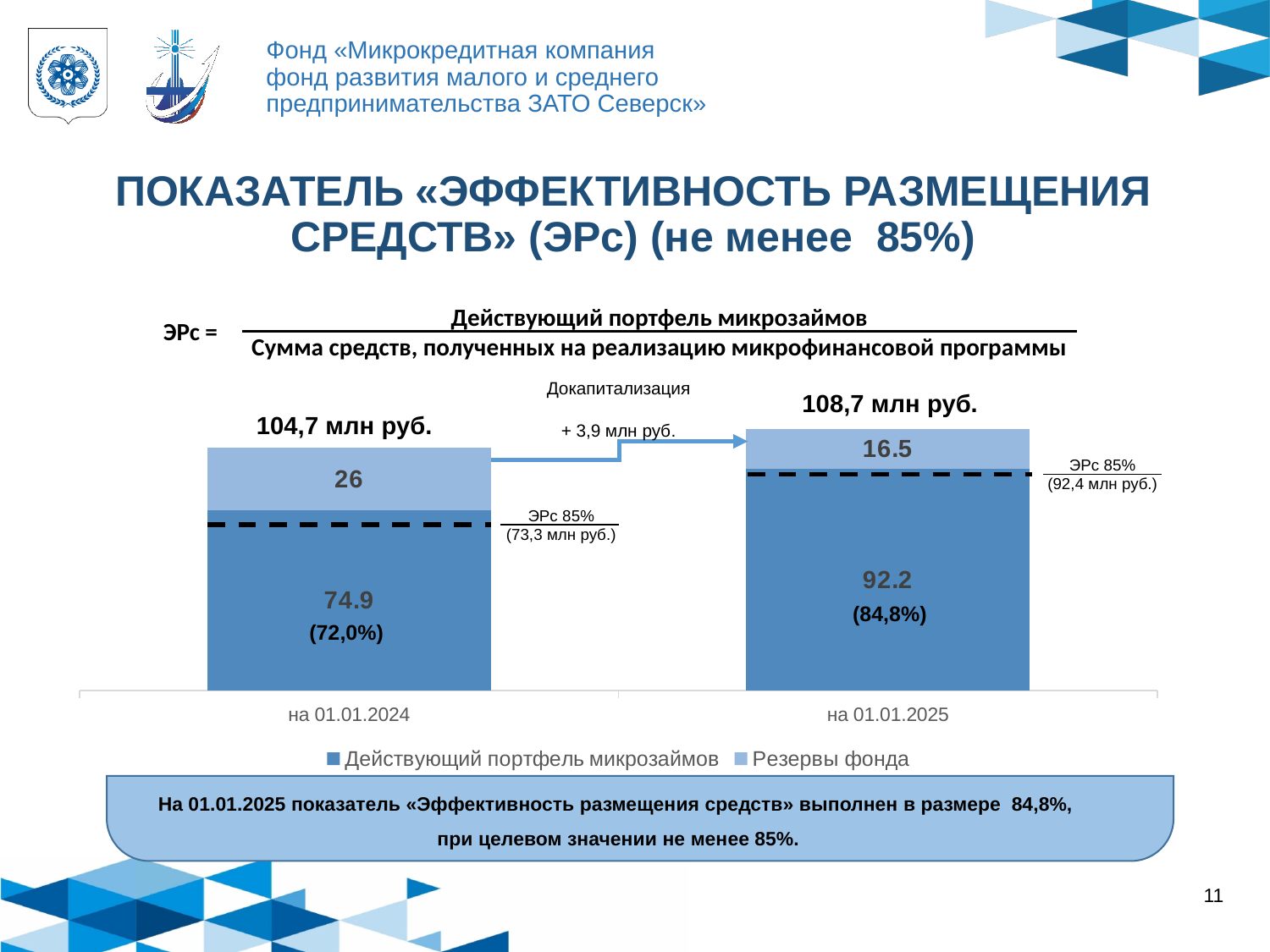
What type of chart is shown on the slide? stacked bar chart Which category has the larger «Резервы фонда» value, «на 01.01.2024» or «на 01.01.2025»? на 01.01.2024 What is the value of «Действующий портфель микрозаймов» for «на 01.01.2025»? 92.2 How many categories are shown on the x axis? 2 What is the value of «Действующий портфель микрозаймов» for «на 01.01.2024»? 74.9 What is the value of «Резервы фонда» for «на 01.01.2025»? 16.5 Does the «Действующий портфель микрозаймов» value rise or fall from «на 01.01.2024» to «на 01.01.2025»? rise What percentage is shown in parentheses inside the «Действующий портфель микрозаймов» segment for «на 01.01.2025»? 84,8% How many series does the legend list? 2 What is the value of «Резервы фонда» for «на 01.01.2024»? 26 What is the difference between the «Действующий портфель микрозаймов» values for «на 01.01.2025» and «на 01.01.2024»? 17.3 What is the total of the stacked bar for «на 01.01.2025»? 108,7 млн руб.